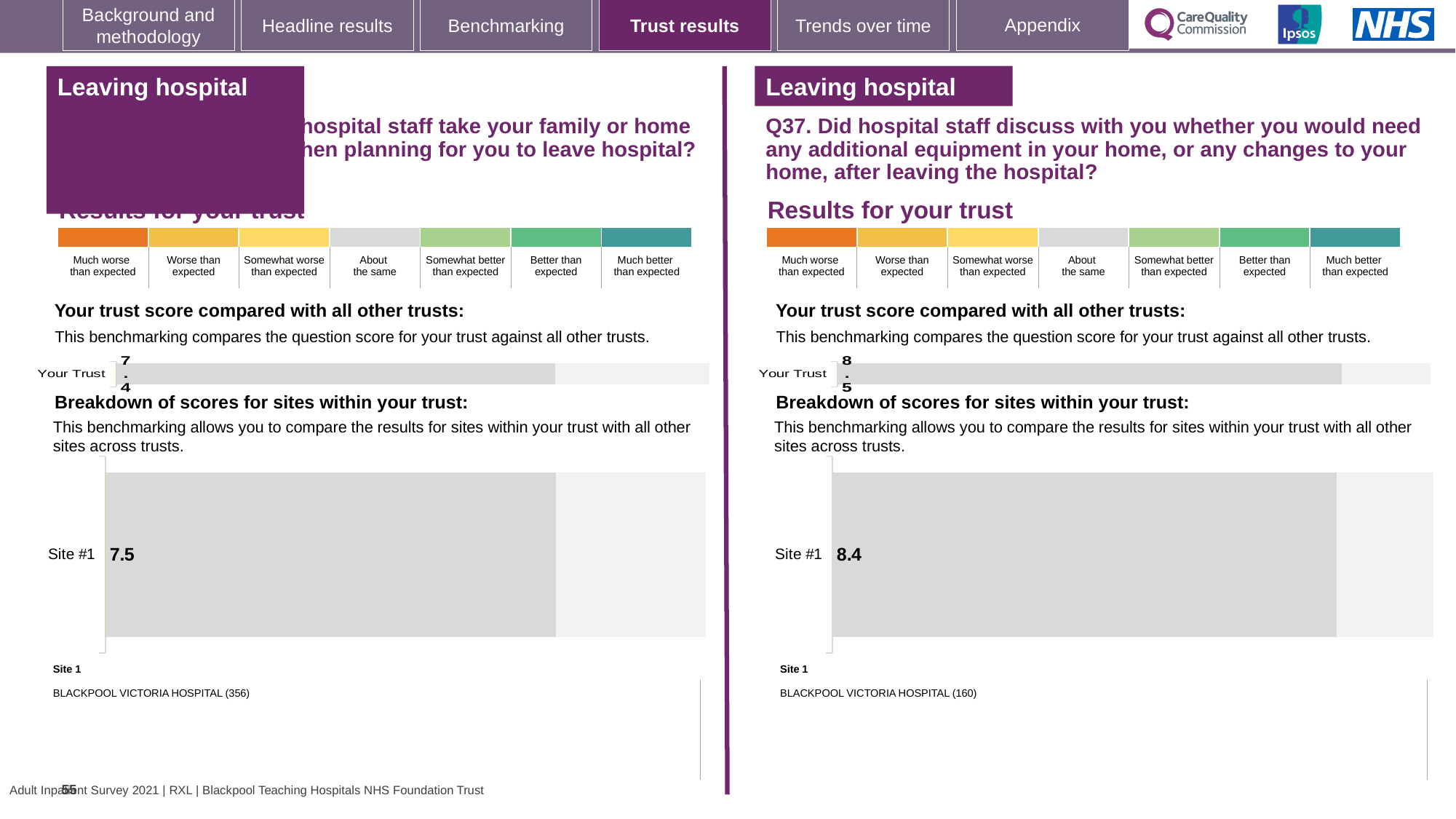
On the right half of the slide (Q37), which is larger: the Your Trust score or the Site #1 score? Your Trust On the left half of the slide, what is the score shown for Site #1? 7.5 What kind of chart is used to show the Site #1 score on the right half of the slide (Q37)? Bar chart On the left half of the slide, which is larger: the Your Trust score or the Site #1 score? Site #1 On the left half of the slide, which hospital is listed as Site 1? BLACKPOOL VICTORIA HOSPITAL (356) How many sites are shown in the site breakdown chart on the left half of the slide? 1 On the right half of the slide (Q37), what is the score shown for Site #1? 8.4 What is the difference between the Your Trust score on the right half of the slide (Q37) and the Your Trust score on the left half? 1.1 On the right half of the slide (Q37), which hospital is listed as Site 1? BLACKPOOL VICTORIA HOSPITAL (160) On the left half of the slide, what is the score shown for Your Trust? 7.4 What is the difference between the Site #1 score on the right half of the slide (Q37) and the Site #1 score on the left half? 0.9 On the right half of the slide (Q37), what is the score shown for Your Trust? 8.5